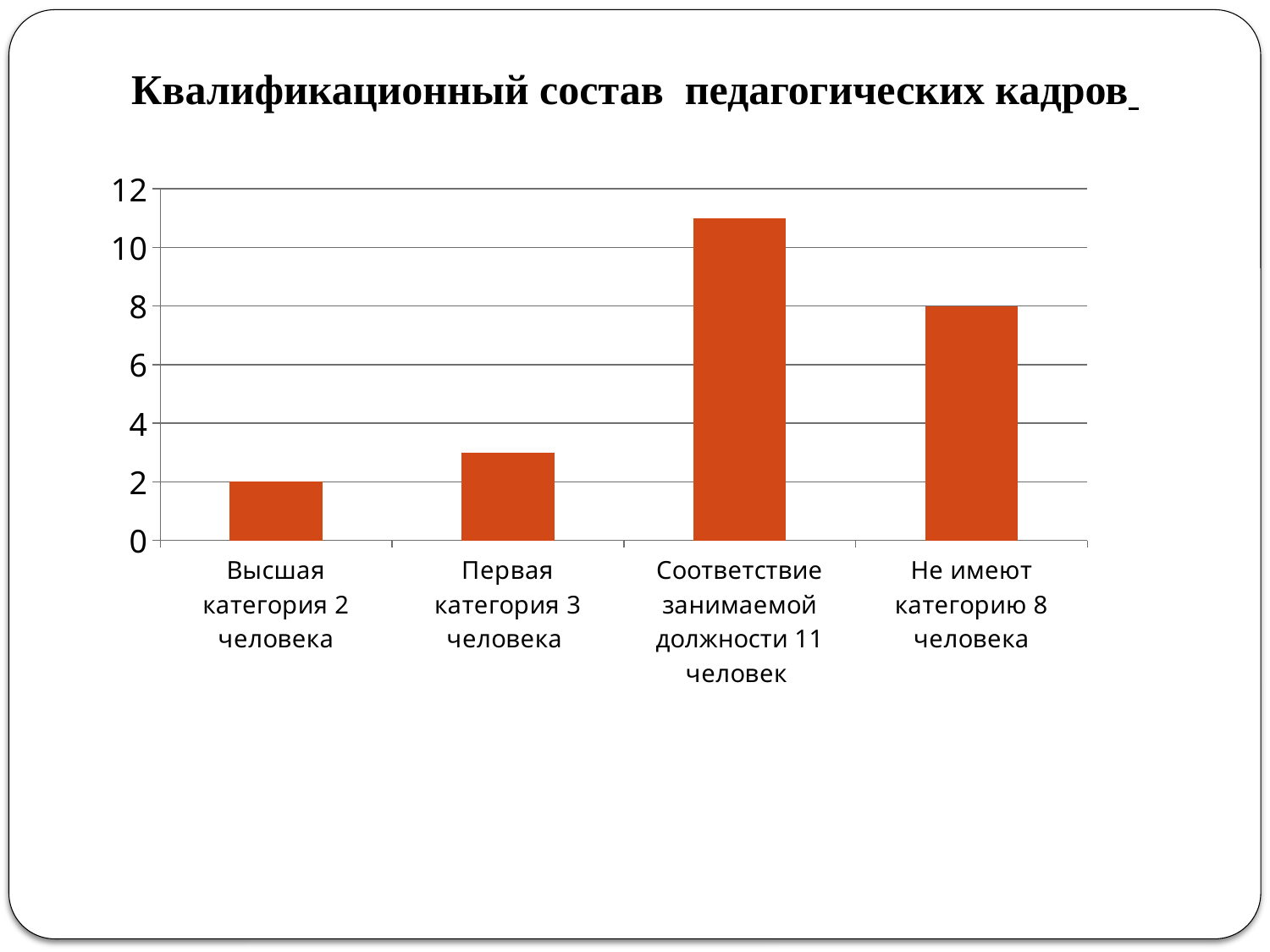
Which is larger: the value for 'Первая категория' or the value for 'Высшая категория'? Первая категория What is the value for the category 'Высшая категория'? 2 Which category has the lowest value? Высшая категория What is the difference between the values for 'Соответствие занимаемой должности' and 'Не имеют категорию'? 3 What is the value for the category 'Первая категория'? 3 What is the value for the category 'Не имеют категорию'? 8 What is the title of the chart? Квалификационный состав педагогических кадров Which category has the highest value? Соответствие занимаемой должности What is the value for the category 'Соответствие занимаемой должности'? 11 What kind of chart is shown on the slide? bar chart How many categories are plotted in the chart? 4 Is the value for 'Соответствие занимаемой должности' greater or less than 10? greater